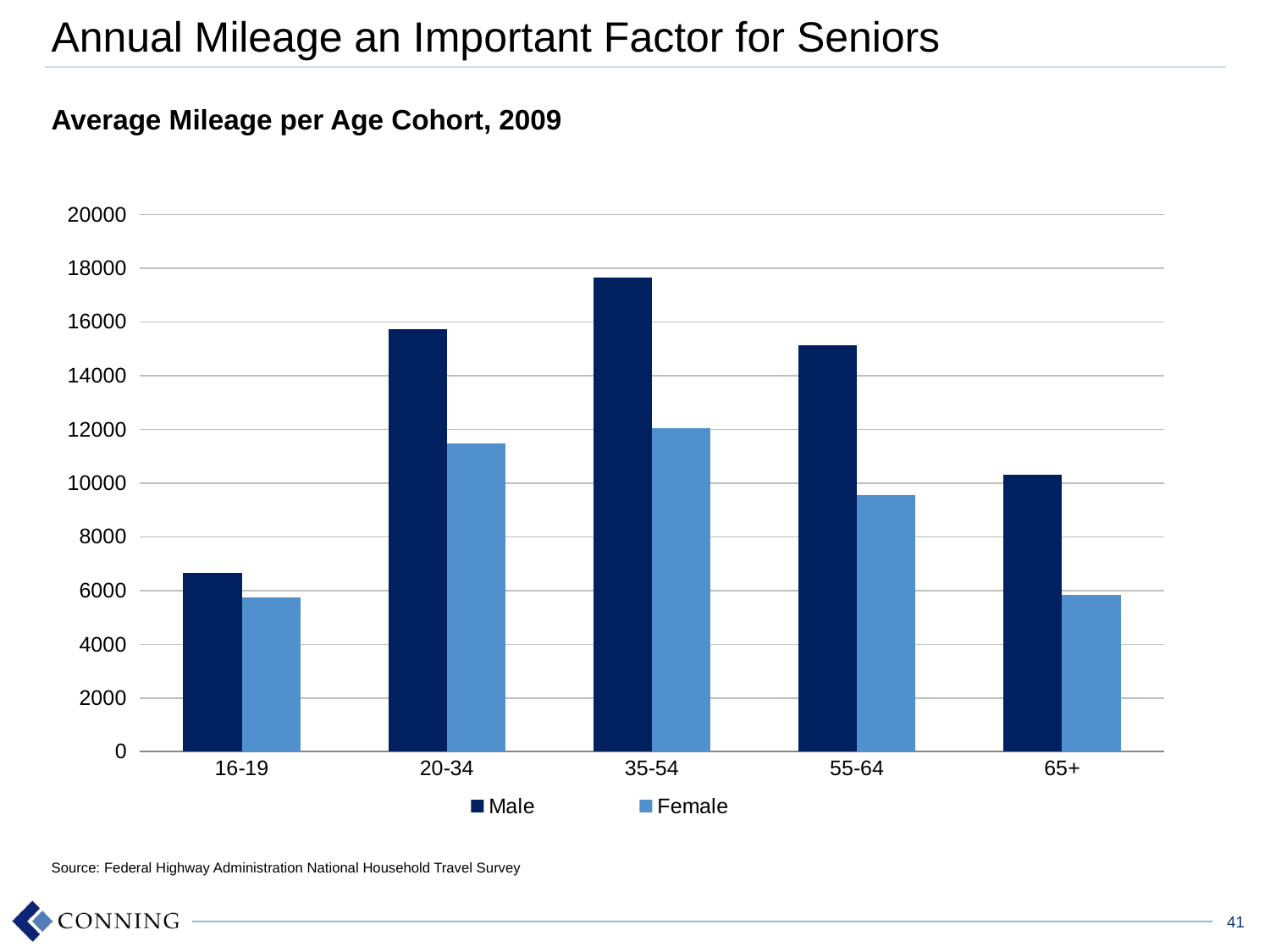
How many age cohorts are shown on the x axis? 5 Which age cohort has the highest Male average mileage? 35-54 Is the Male value for 65+ greater or less than 10000? greater How many series does the legend list? 2 Is the Female value for 20-34 greater or less than 12000? less Which age cohort has the highest Female average mileage? 35-54 Which age cohort has the lowest Male average mileage? 16-19 What kind of chart is shown on the slide? bar chart Is the Male value for 35-54 greater or less than 18000? less Which is larger for the 65+ cohort, the Male value or the Female value? Male What is the title of the chart? Average Mileage per Age Cohort, 2009